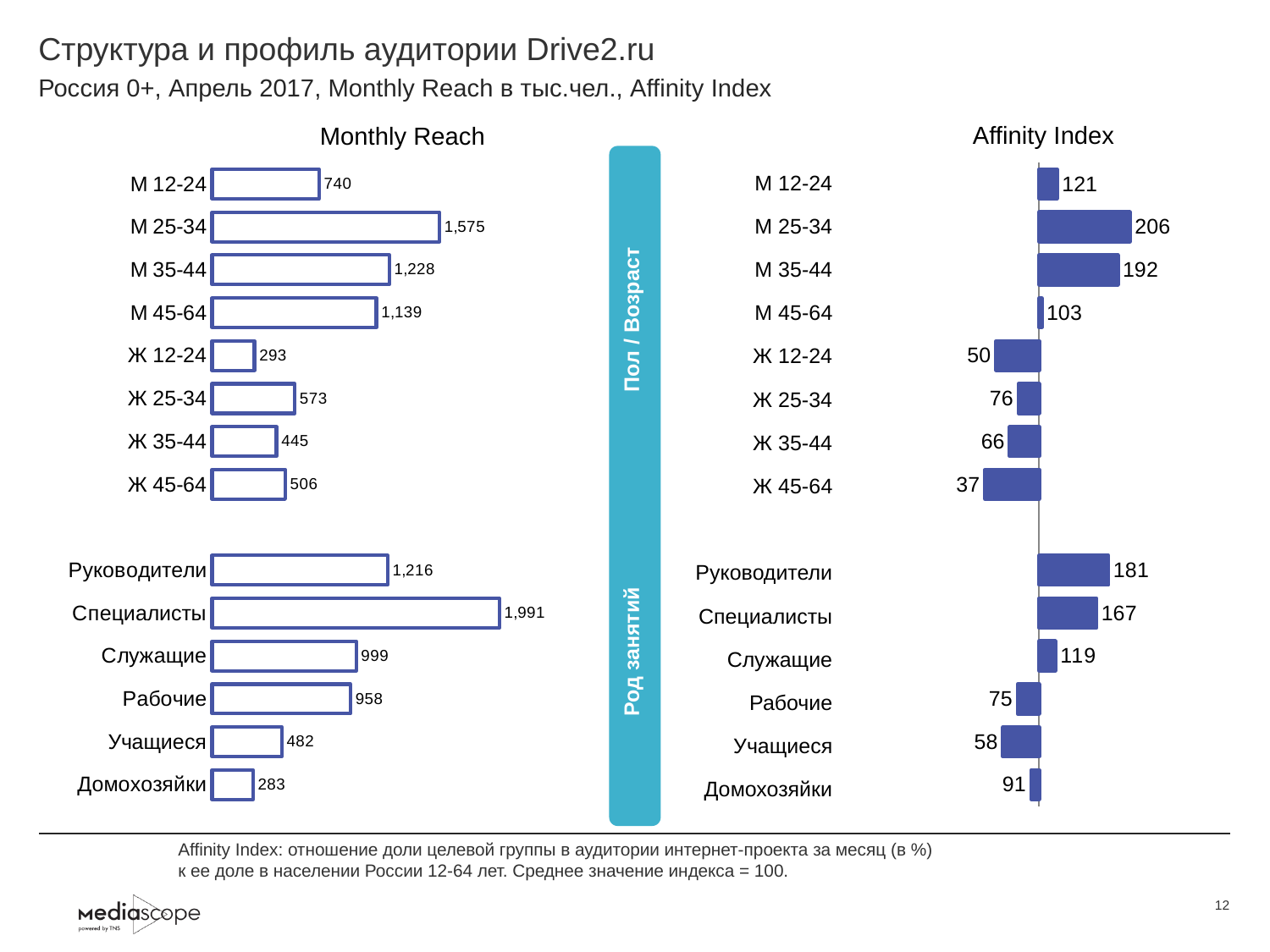
In the Monthly Reach chart, which is larger, the value for Служащие or the value for Рабочие? Служащие In the Affinity Index chart, which category has the lowest value? Ж 45-64 How many categories are shown in the Monthly Reach chart? 14 In the Affinity Index chart, what is the difference between the values for Руководители and Специалисты? 14 What kind of chart is the Affinity Index chart? Bar chart In the Affinity Index chart, which is larger, the value for Ж 25-34 or the value for Ж 35-44? Ж 25-34 In the Monthly Reach chart, what is the value for М 25-34? 1,575 In the Monthly Reach chart, which category has the lowest value? Домохозяйки In the Affinity Index chart, what is the value for Ж 45-64? 37 In the Monthly Reach chart, which category has the highest value? Специалисты In the Monthly Reach chart, what is the difference between the values for М 25-34 and М 35-44? 347 In the Affinity Index chart, which category has the highest value? М 25-34